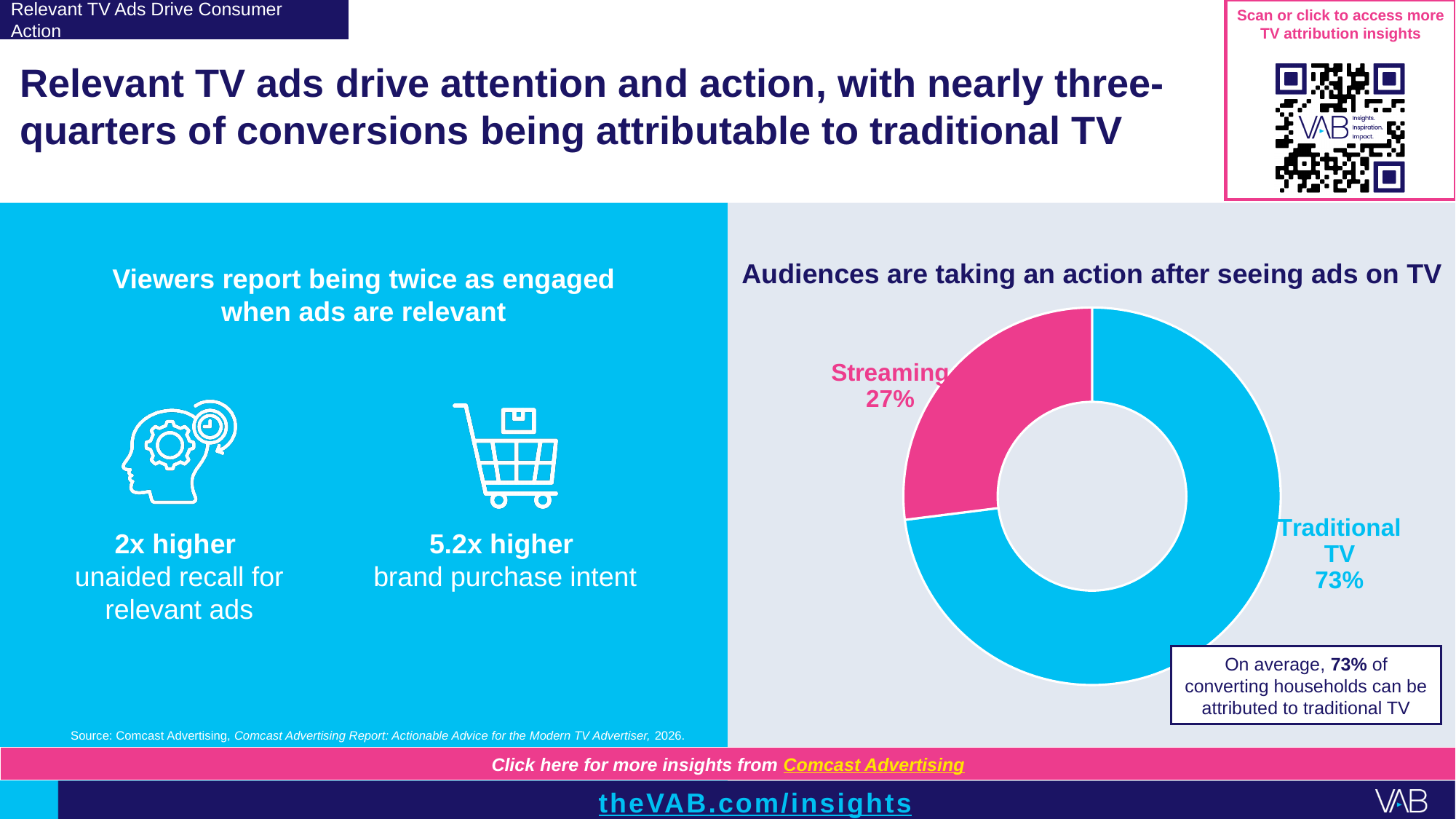
Which category has the smallest share of the chart? Streaming What share of the chart does the Streaming slice represent? 27% How many categories are shown in the chart? 2 Which category has the largest share of the chart? Traditional TV What is the difference between the Traditional TV and Streaming shares? 46% What colour is the Streaming slice in the chart? Pink What is the title of the chart? Audiences are taking an action after seeing ads on TV What is the value for Streaming in the chart? 27% What is the value for Traditional TV in the chart? 73% Which is larger, the share for Streaming or the share for Traditional TV? Traditional TV What kind of chart is shown on the slide? Pie chart (donut)